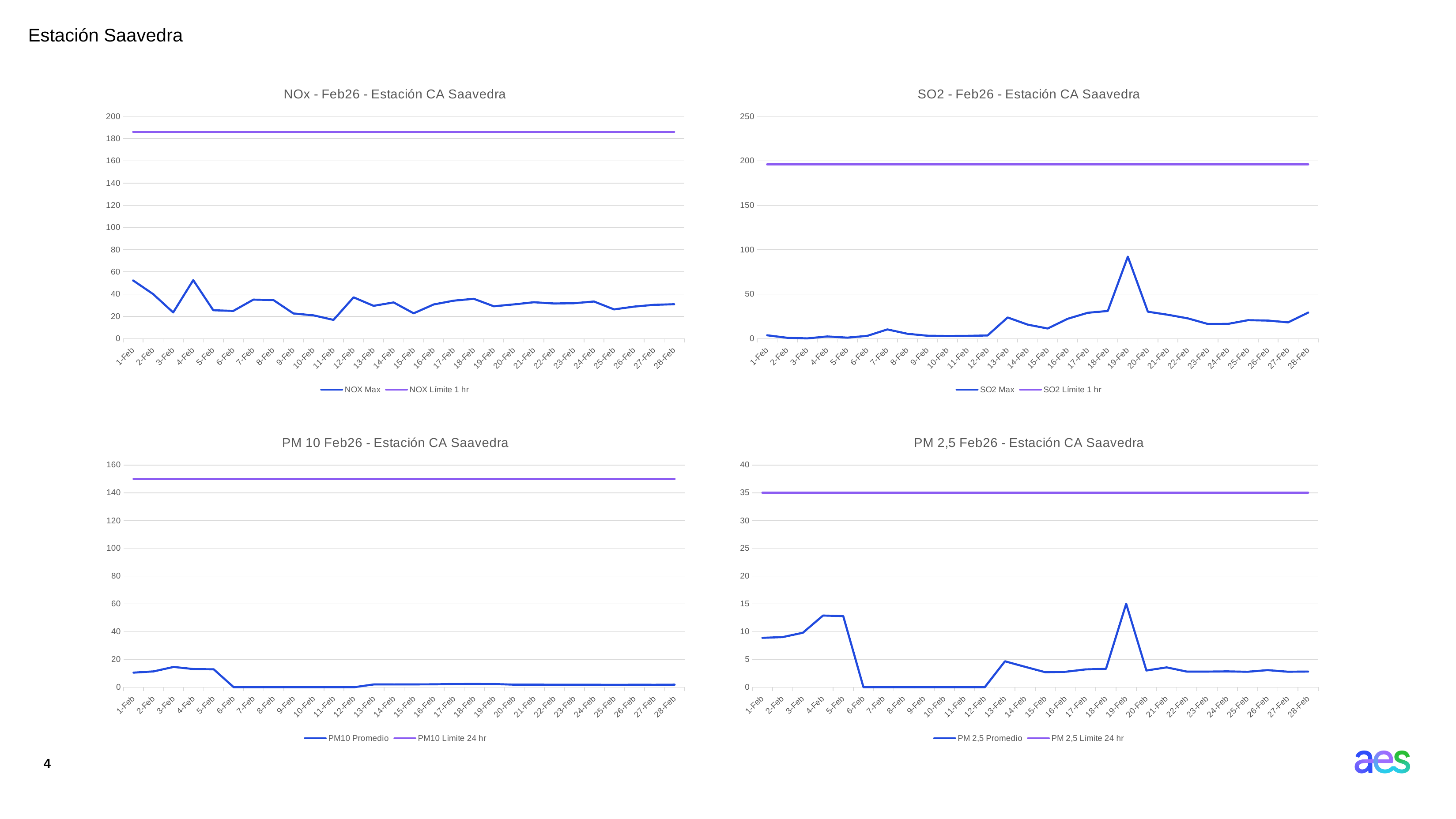
In the PM 2,5 Feb26 - Estación CA Saavedra chart, on which date is PM 2,5 Promedio highest? 19-Feb In the PM 10 Feb26 - Estación CA Saavedra chart, is the PM10 Límite 24 hr line greater or less than 140? greater In the NOx - Feb26 - Estación CA Saavedra chart, on which date is NOX Max lowest? 11-Feb In the PM 2,5 Feb26 - Estación CA Saavedra chart, what is the value of the PM 2,5 Límite 24 hr line? 35 How many series does the legend of the PM 10 Feb26 - Estación CA Saavedra chart list? 2 In the SO2 - Feb26 - Estación CA Saavedra chart, is the SO2 Max value on 19-Feb greater or less than 50? greater In the SO2 - Feb26 - Estación CA Saavedra chart, on which date is SO2 Max highest? 19-Feb In the NOx - Feb26 - Estación CA Saavedra chart, is the NOX Max value on 1-Feb greater or less than 40? greater In the SO2 - Feb26 - Estación CA Saavedra chart, how many dates are shown on the x axis? 28 In the NOx - Feb26 - Estación CA Saavedra chart, which date has the larger NOX Max value, 3-Feb or 4-Feb? 4-Feb What kind of chart is the NOx - Feb26 - Estación CA Saavedra chart? line chart What are the two legend entries of the PM 10 Feb26 - Estación CA Saavedra chart? PM10 Promedio and PM10 Límite 24 hr